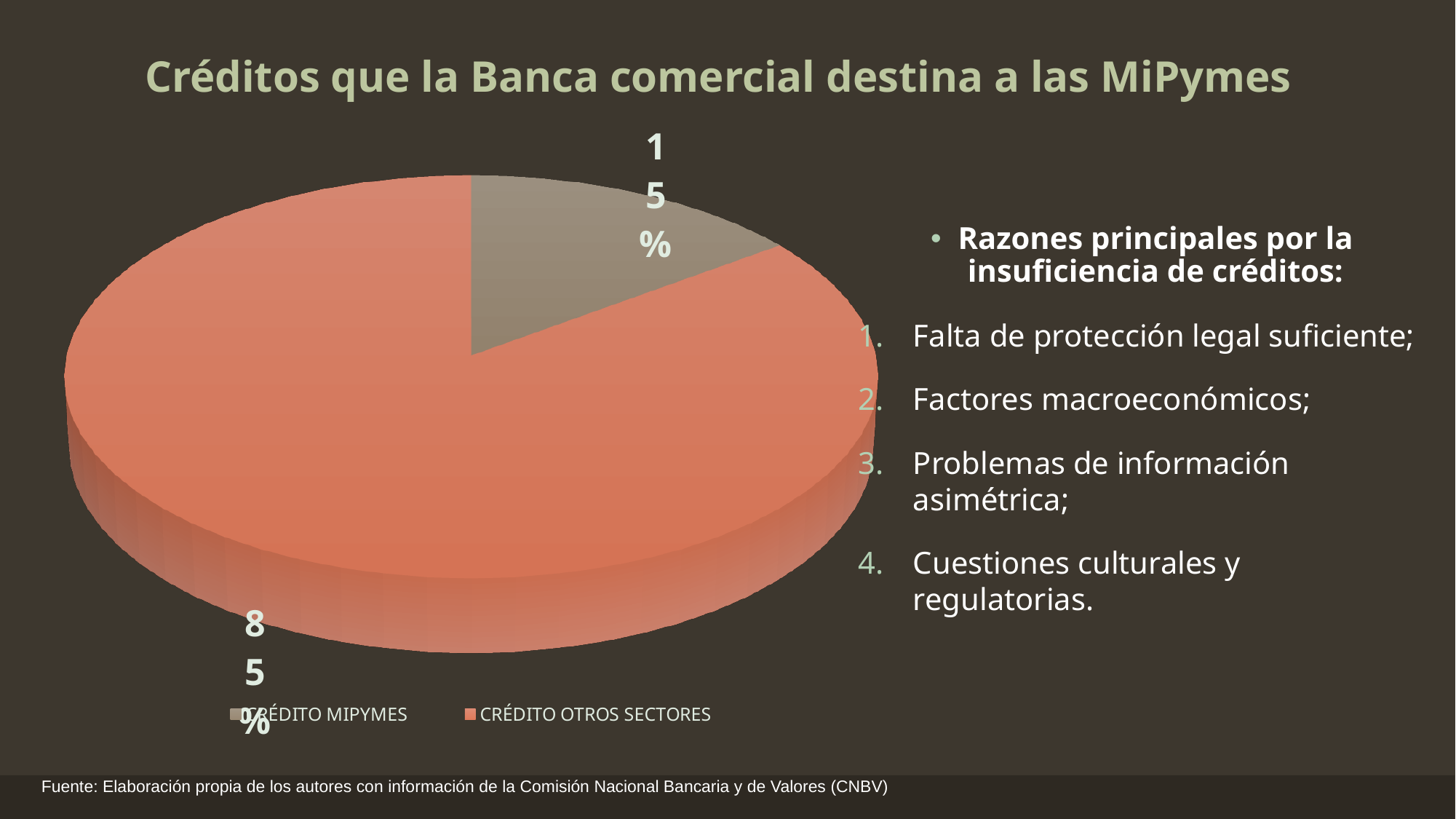
Which slice of the pie is the largest? CRÉDITO OTROS SECTORES Which slice of the pie is the smallest? CRÉDITO MIPYMES What is the title of the slide containing the chart? Créditos que la Banca comercial destina a las MiPymes What share of the pie does CRÉDITO MIPYMES represent? 15% What colour is the CRÉDITO OTROS SECTORES slice? Orange How many slices does the pie chart have? 2 What kind of chart is shown on the slide? Pie chart What share of the pie does CRÉDITO OTROS SECTORES represent? 85% What is the difference in percentage points between CRÉDITO OTROS SECTORES and CRÉDITO MIPYMES? 70 Which is larger, the share for CRÉDITO MIPYMES or the share for CRÉDITO OTROS SECTORES? CRÉDITO OTROS SECTORES How many entries does the legend list? 2